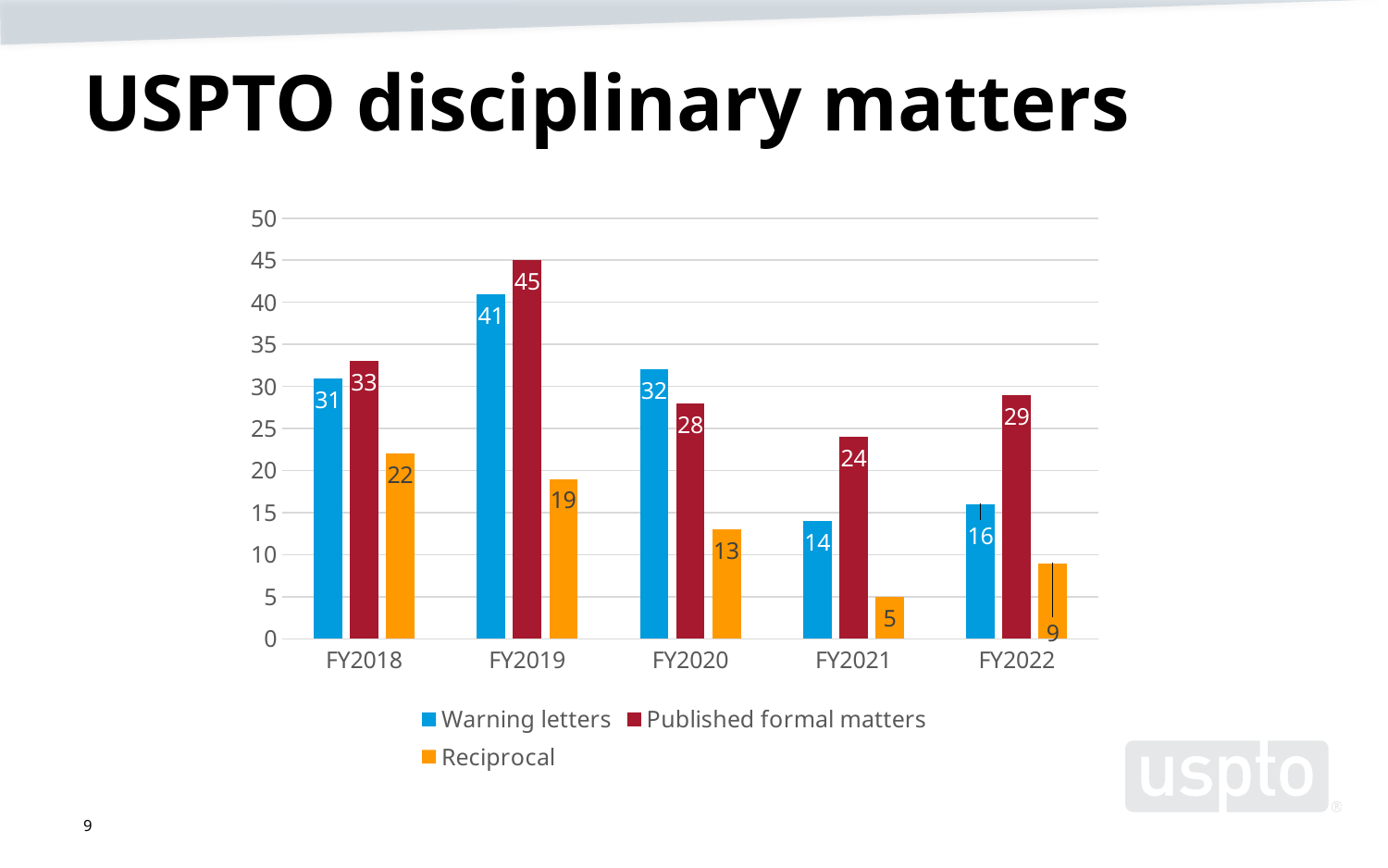
Does the Reciprocal series rise or fall from FY2018 to FY2021? Fall Which fiscal year has the lowest value for Warning letters? FY2021 How many fiscal years are shown on the x axis? 5 Which fiscal year has the highest value for Published formal matters? FY2019 Which is larger in FY2020: Warning letters or Published formal matters? Warning letters What is the value for Warning letters in FY2019? 41 What kind of chart is shown on the slide? Bar chart How many series does the legend list? 3 What is the value for Published formal matters in FY2021? 24 What is the difference between Published formal matters and Warning letters in FY2022? 13 What is the value for Reciprocal in FY2022? 9 Is the value for Reciprocal in FY2018 greater or less than 20? greater